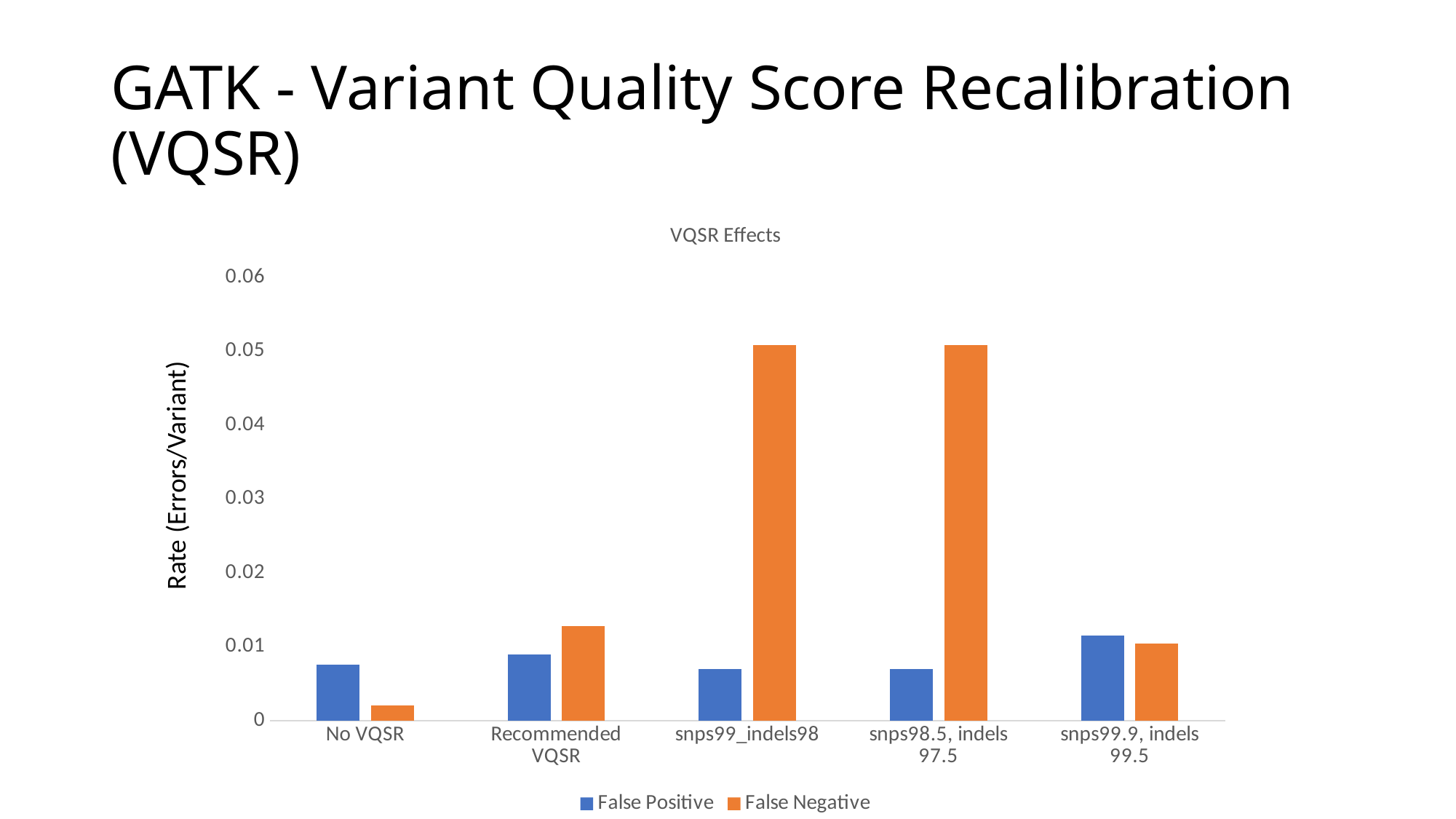
What is the label on the vertical axis of the chart? Rate (Errors/Variant) What is the title of the chart? VQSR Effects How many series does the legend of the VQSR Effects chart list? 2 How many categories are shown on the x axis of the VQSR Effects chart? 5 Is the False Negative value for snps99_indels98 greater or less than 0.04? greater Which category has the lowest False Negative rate? No VQSR What kind of chart is shown on the slide? bar chart For Recommended VQSR, which is larger: the False Positive rate or the False Negative rate? False Negative Is the False Positive value for No VQSR greater or less than 0.01? less Is the False Negative value for No VQSR greater or less than 0.01? less Which category has the highest False Positive rate? snps99.9, indels 99.5 For No VQSR, which is larger: the False Positive rate or the False Negative rate? False Positive